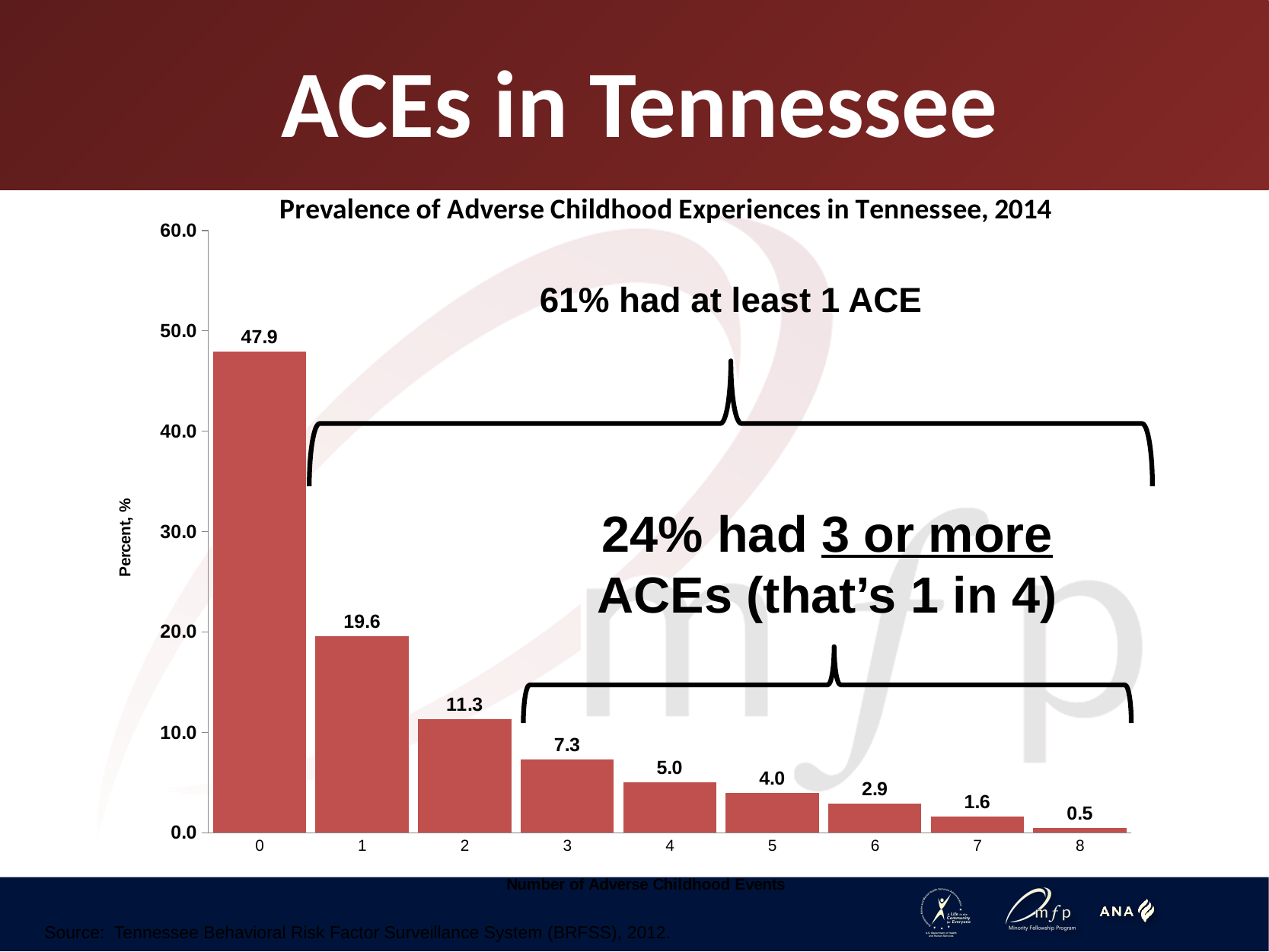
Which number of adverse childhood events has the highest percentage? 0 What is the percentage of people with 8 adverse childhood events? 0.5 Which number of adverse childhood events has the lowest percentage? 8 What is the title of the chart? Prevalence of Adverse Childhood Experiences in Tennessee, 2014 Which has a larger percentage: 4 ACEs or 5 ACEs? 4 ACEs What kind of chart is shown on the slide? Bar chart Do the values rise or fall as the number of adverse childhood events increases? Fall How many categories (numbers of adverse childhood events) are shown on the x axis? 9 What is the percentage of people with 0 adverse childhood events? 47.9 What is the difference in percent between 1 ACE and 2 ACEs? 8.3 Is the value for 0 ACEs greater or less than 40.0? greater What is the percentage of people with 3 adverse childhood events? 7.3